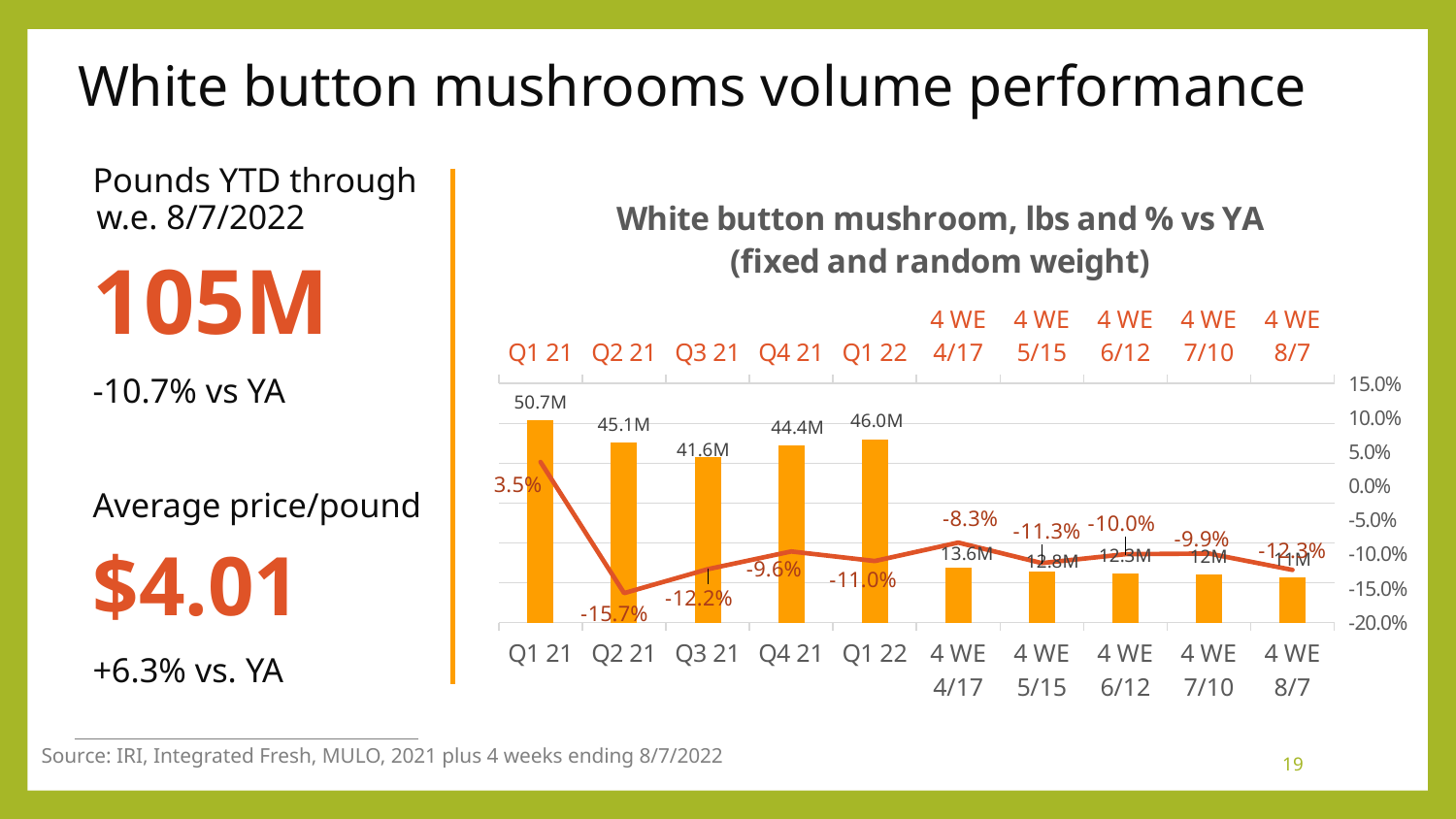
What is the % vs YA value for Q2 21? -15.7% What is the difference in pounds between Q1 21 and Q2 21? 5.6M Which has the higher volume in pounds, Q3 21 or Q4 21? Q4 21 Do the bar values rise or fall from Q3 21 to Q1 22? Rise What is the % vs YA value for the 4 WE 4/17 period? -8.3% What is the title of the chart? White button mushroom, lbs and % vs YA (fixed and random weight) Which period has the lowest % vs YA value? Q2 21 Which period has the highest volume in pounds? Q1 21 What kind of chart is this? Combined bar and line chart What is the volume in pounds for the 4 WE 8/7 period? 11M What is the volume in pounds for Q1 21? 50.7M How many periods are shown on the x axis? 10